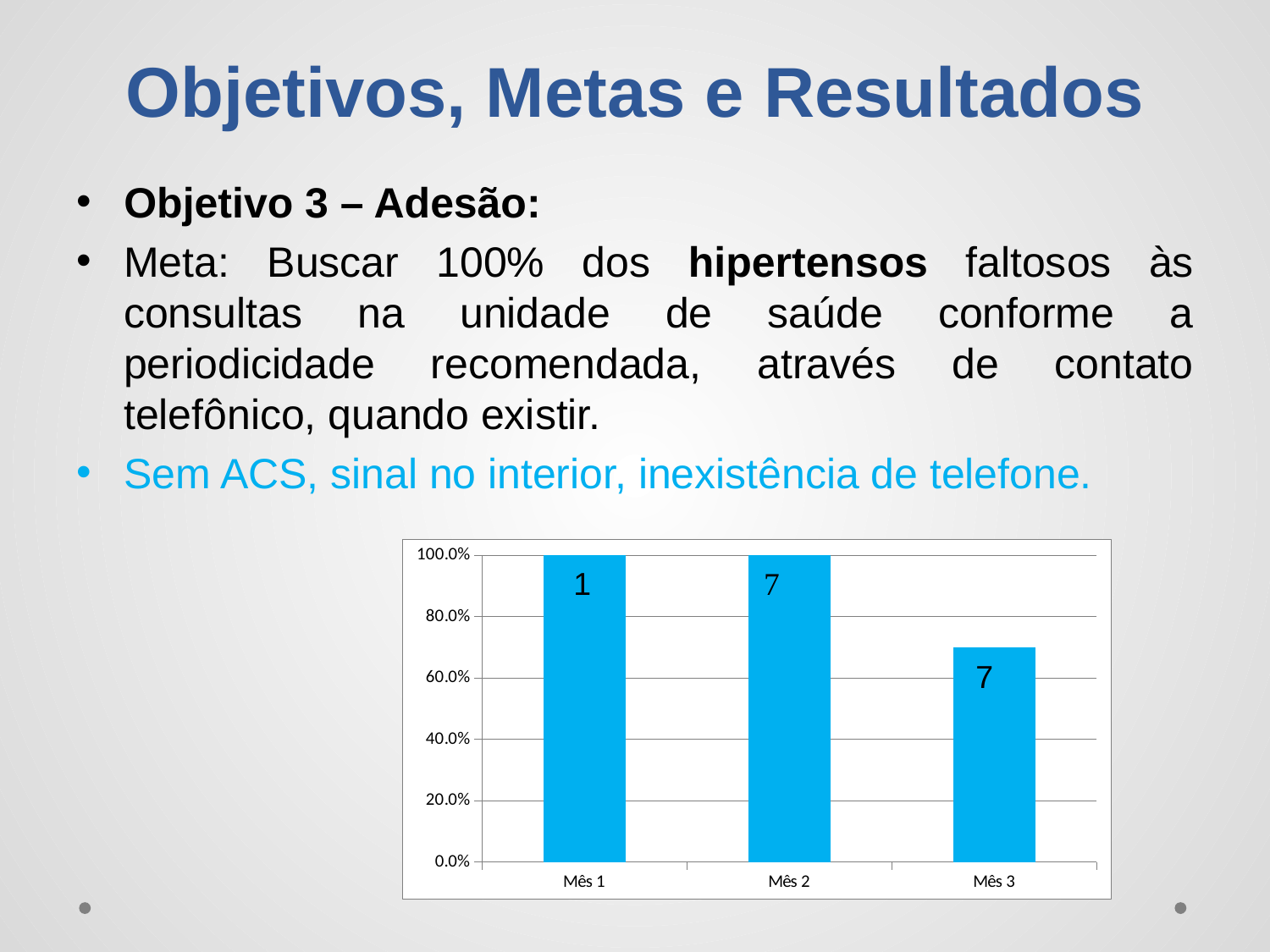
How many categories (months) are shown on the x axis of the chart? 3 Which bar is taller, Mês 1 or Mês 3? Mês 1 Is the value for Mês 3 greater or less than 60.0%? greater What number is printed as the data label on the bar for Mês 2? 7 Does the bar height rise or fall from Mês 2 to Mês 3? fall What percentage value does the bar for Mês 2 reach on the y axis? 100.0% What kind of chart is shown on the slide? bar chart What percentage value does the bar for Mês 1 reach on the y axis? 100.0% Is the value for Mês 3 greater or less than 80.0%? less Which month has the lowest bar in the chart? Mês 3 What number is printed as the data label on the bar for Mês 1? 1 What number is printed as the data label on the bar for Mês 3? 7